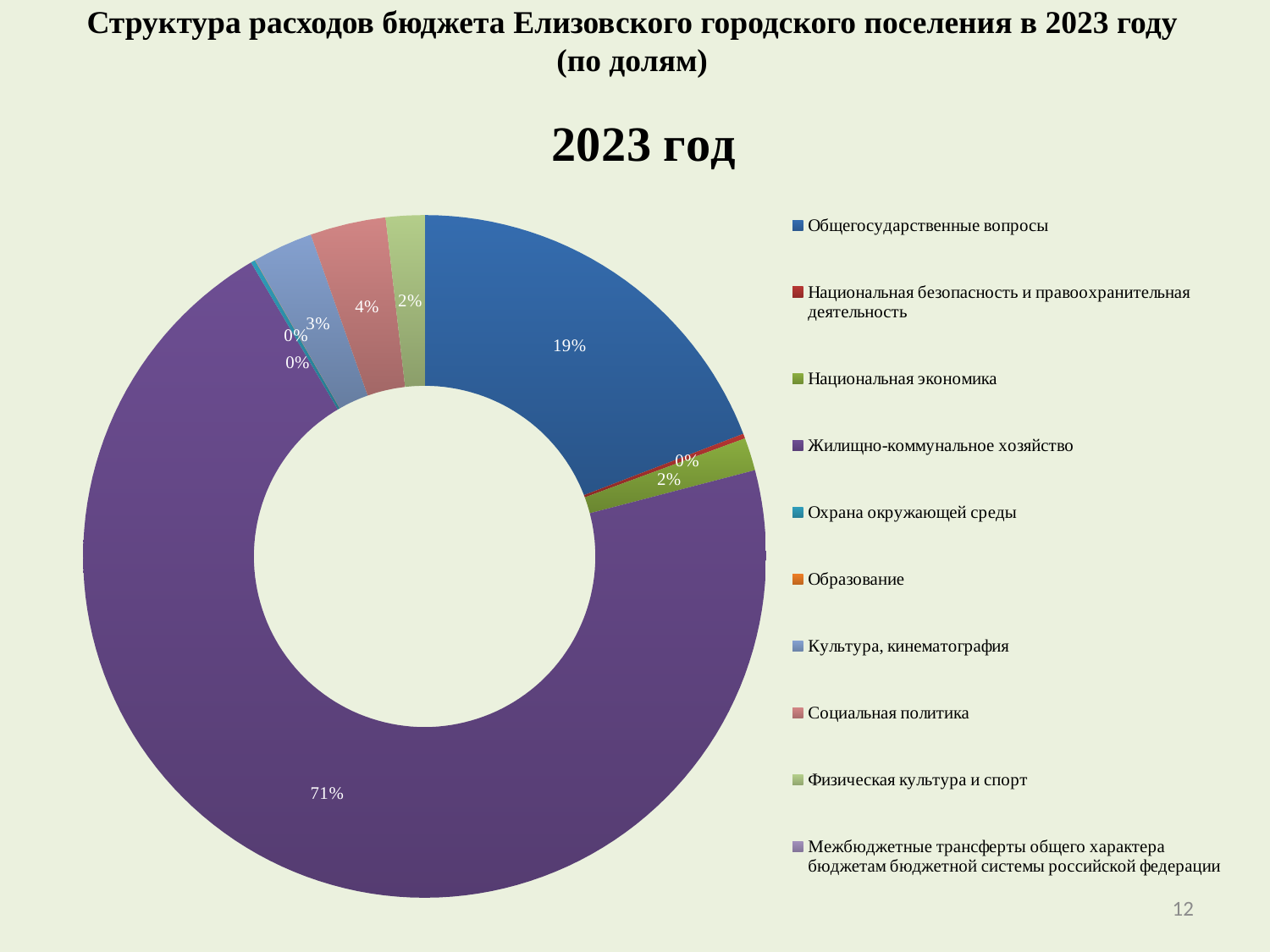
What share of the 2023 budget expenditure goes to Национальная экономика? 2% Which expenditure category has the largest share in the 2023 chart? Жилищно-коммунальное хозяйство What share of the 2023 budget expenditure goes to Жилищно-коммунальное хозяйство? 71% What is the difference in percentage points between the share for Жилищно-коммунальное хозяйство and the share for Общегосударственные вопросы? 52 percentage points What colour is the slice for Общегосударственные вопросы? Blue How many categories does the legend of the chart list? 10 What share of the 2023 budget expenditure goes to Культура, кинематография? 3% What is the title shown above the chart? 2023 год Which is larger: the share for Социальная политика or the share for Культура, кинематография? Социальная политика What kind of chart is shown on the slide? Doughnut (pie) chart What share of the 2023 budget expenditure goes to Социальная политика? 4% What share of the 2023 budget expenditure goes to Общегосударственные вопросы? 19%